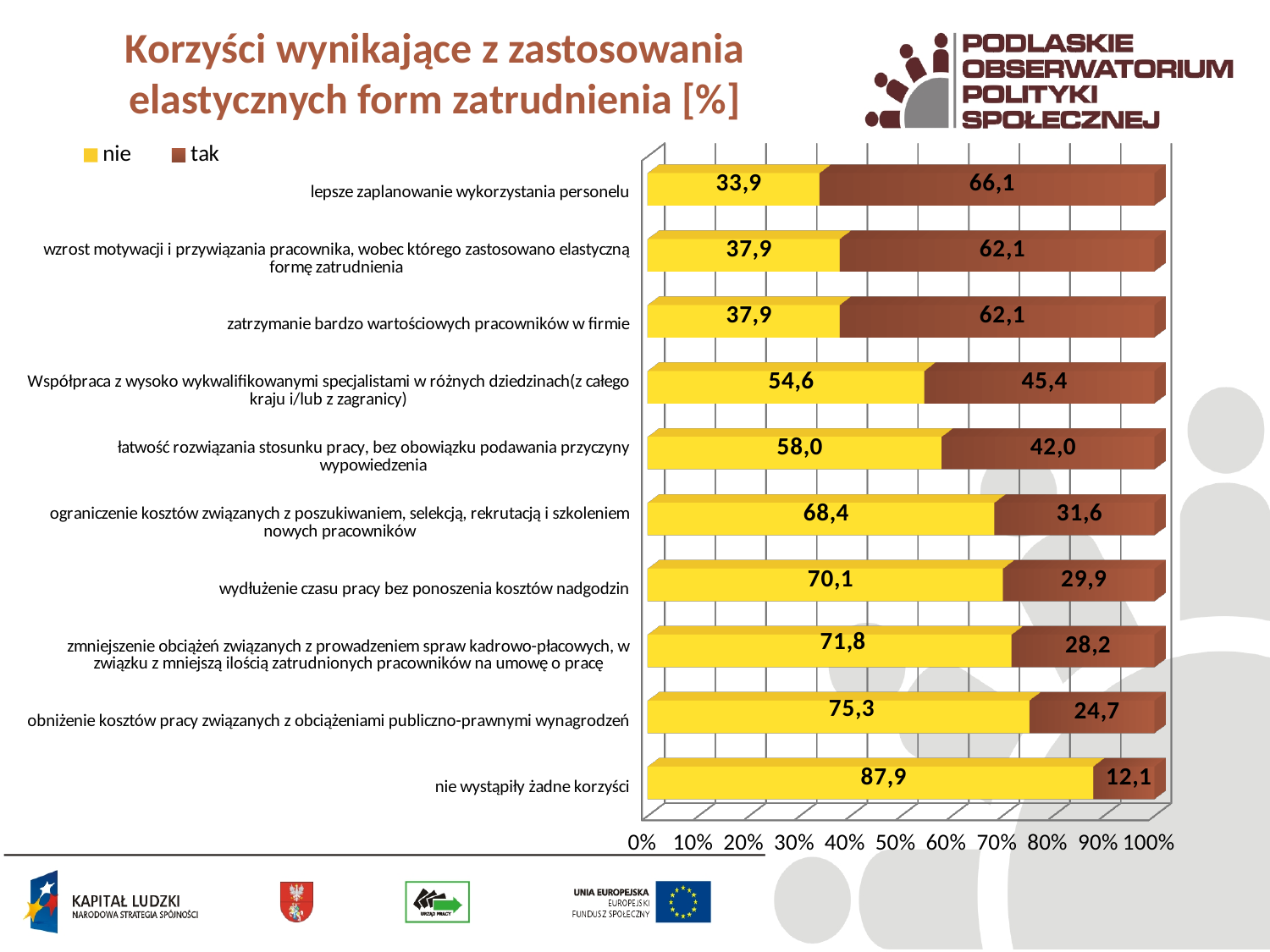
Which category has the highest "tak" value? lepsze zaplanowanie wykorzystania personelu Which category has the lowest "tak" value? nie wystąpiły żadne korzyści What is the difference between the "nie" and "tak" values for "obniżenie kosztów pracy związanych z obciążeniami publiczno-prawnymi wynagrodzeń"? 50,6 Which colour represents the "tak" series in the chart? brown What is the "nie" value for "wydłużenie czasu pracy bez ponoszenia kosztów nadgodzin"? 70,1 What is the total of the stacked bar for "łatwość rozwiązania stosunku pracy, bez obowiązku podawania przyczyny wypowiedzenia"? 100,0 How many categories are shown in the chart? 10 Which is larger for "Współpraca z wysoko wykwalifikowanymi specjalistami w różnych dziedzinach": the "nie" value or the "tak" value? nie What is the "nie" value for "nie wystąpiły żadne korzyści"? 87,9 How many series does the legend list? 2 What is the "tak" value for "lepsze zaplanowanie wykorzystania personelu"? 66,1 What kind of chart is shown on the slide? stacked bar chart